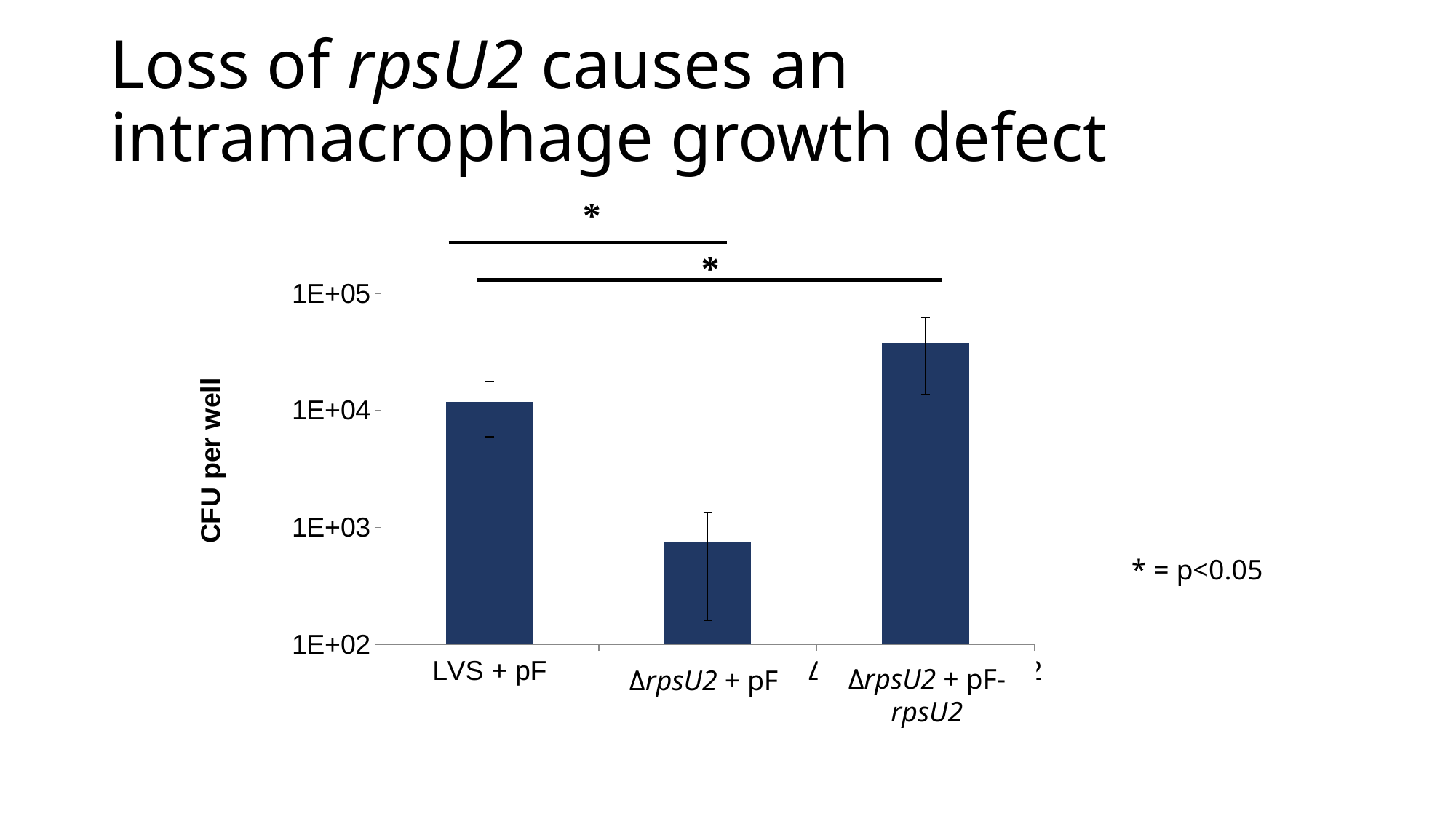
What is the label of the y-axis of the chart? CFU per well According to the slide, what does the asterisk (*) above the chart indicate? p<0.05 Is the value for ΔrpsU2 + pF greater or less than 1E+03? less Which category has the highest CFU per well? ΔrpsU2 + pF-rpsU2 What kind of chart is shown on the slide? bar chart Is the value for ΔrpsU2 + pF-rpsU2 greater or less than 1E+04? greater How many categories (bars) are plotted in the chart? 3 Which has a higher CFU per well, ΔrpsU2 + pF-rpsU2 or ΔrpsU2 + pF? ΔrpsU2 + pF-rpsU2 Which has a higher CFU per well, LVS + pF or ΔrpsU2 + pF? LVS + pF Is the value for ΔrpsU2 + pF-rpsU2 greater or less than 1E+05? less Which category has the lowest CFU per well? ΔrpsU2 + pF